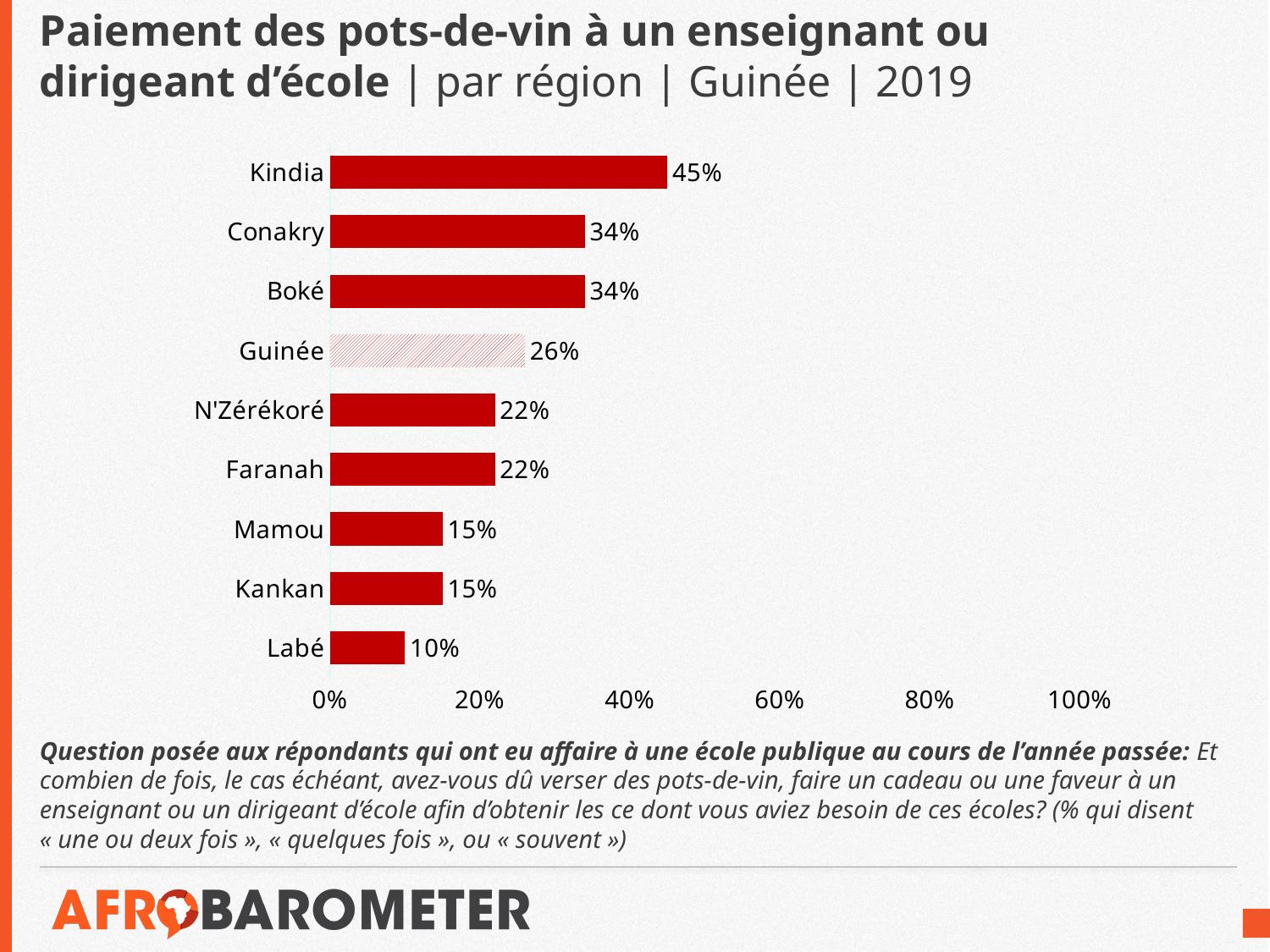
What is the value for Labé? 10% What kind of chart is shown on the slide? Bar chart Which is larger, the value for Mamou or the value for N'Zérékoré? N'Zérékoré What is the difference between the values for Kindia and Conakry? 11% Which region has the lowest value? Labé What is the value for Guinée? 26% What is the value for Kindia? 45% What is the value for Faranah? 22% How many categories are shown in the chart? 9 Which category's bar is drawn with a hatched pattern instead of solid red? Guinée Is the value for Boké greater or less than 40%? less Which region has the highest value? Kindia